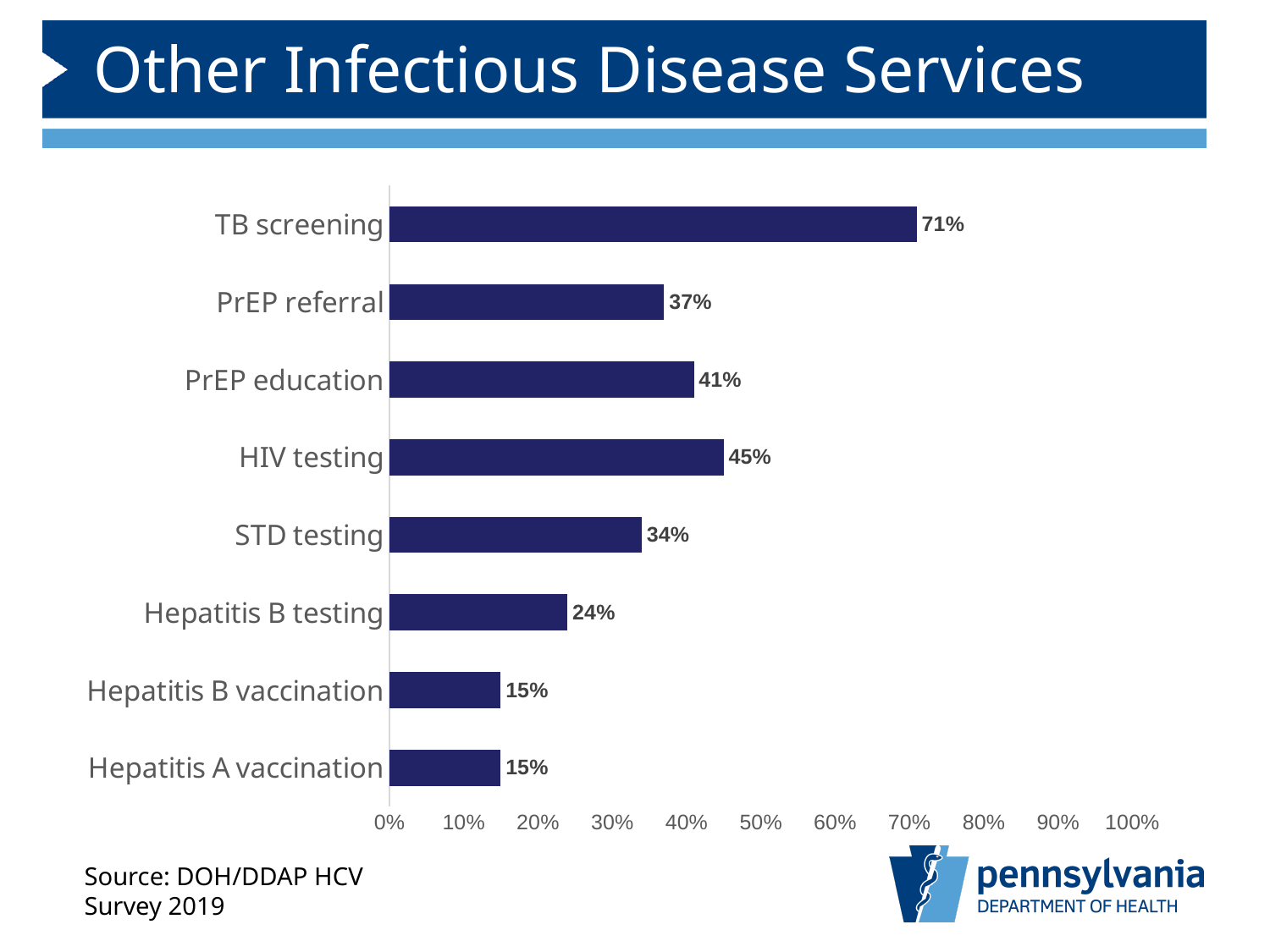
What is the value for HIV testing? 45% What is the value for TB screening? 71% Which is larger, the value for PrEP education or the value for PrEP referral? PrEP education What is the value for Hepatitis B testing? 24% What is the difference between the values for TB screening and PrEP referral? 34% Is the value for STD testing greater or less than 30%? greater What is the title of the slide? Other Infectious Disease Services What kind of chart is shown on the slide? bar chart Which category has the highest value? TB screening What is the difference between the values for PrEP education and STD testing? 7% What source is cited for the chart data? DOH/DDAP HCV Survey 2019 How many categories are shown in the chart? 8